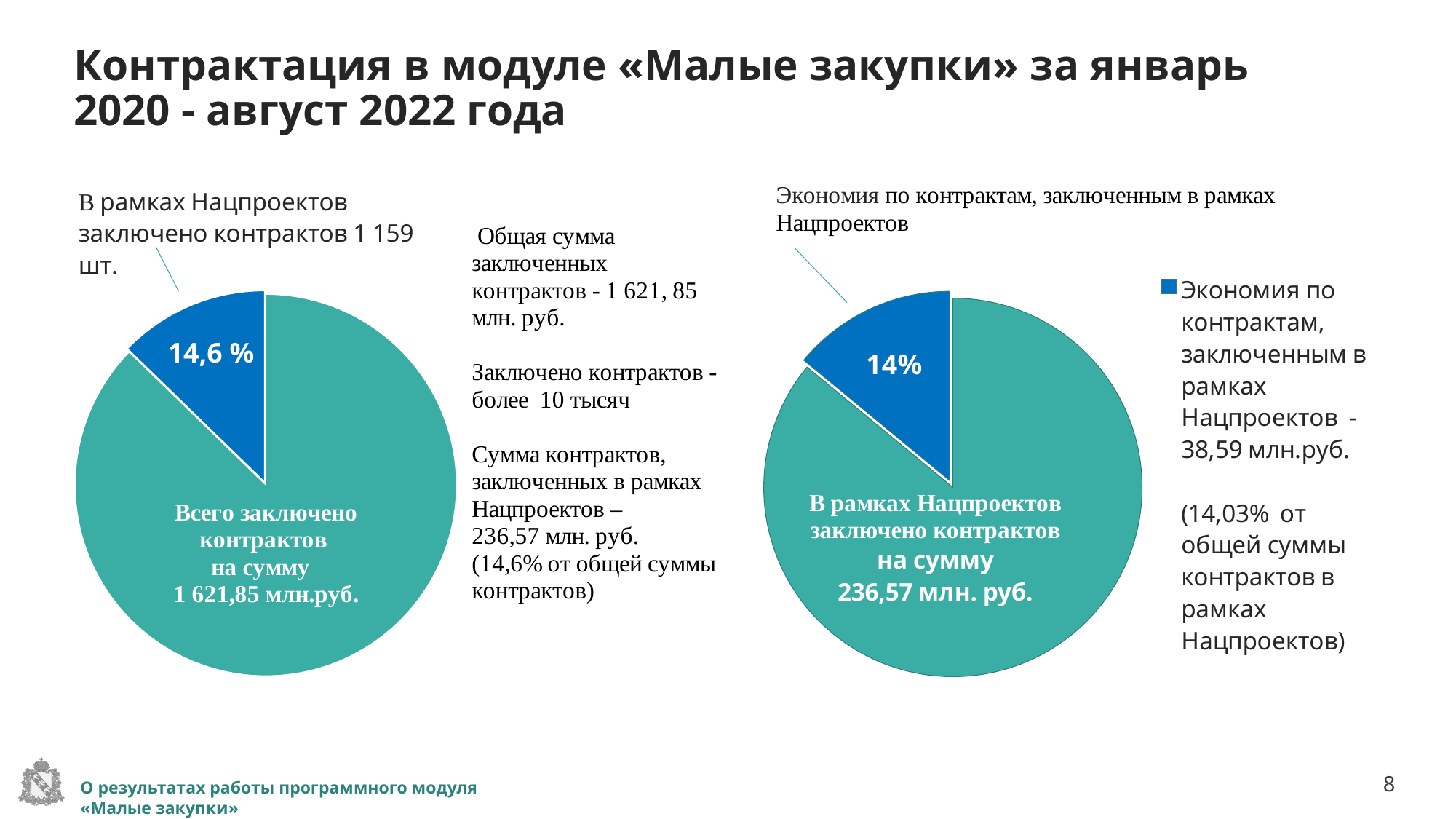
How many slices does the left pie chart have? 2 In the left pie chart, what share is shown on the blue slice for contracts concluded under National Projects (В рамках Нацпроектов)? 14,6 % What kind of chart is the left chart on the slide? pie chart In the right pie chart, what contract sum under National Projects is written in the centre of the pie? 236,57 млн. руб. In the right pie chart, which slice is larger, the blue one or the teal one? teal According to the legend of the right pie chart, what is the amount of savings on contracts concluded under National Projects? 38,59 млн.руб. In the left pie chart, which slice is larger, the blue one or the teal one? teal In the right pie chart, what share is shown on the blue slice for savings on contracts under National Projects (Экономия по контрактам)? 14% What kind of chart is the right chart on the slide? pie chart How many slices does the right pie chart have? 2 According to the callout on the left pie chart, how many contracts were concluded under National Projects? 1 159 шт. In the left pie chart, what total contract sum is written in the centre of the pie (Всего заключено контрактов на сумму)? 1 621,85 млн.руб.